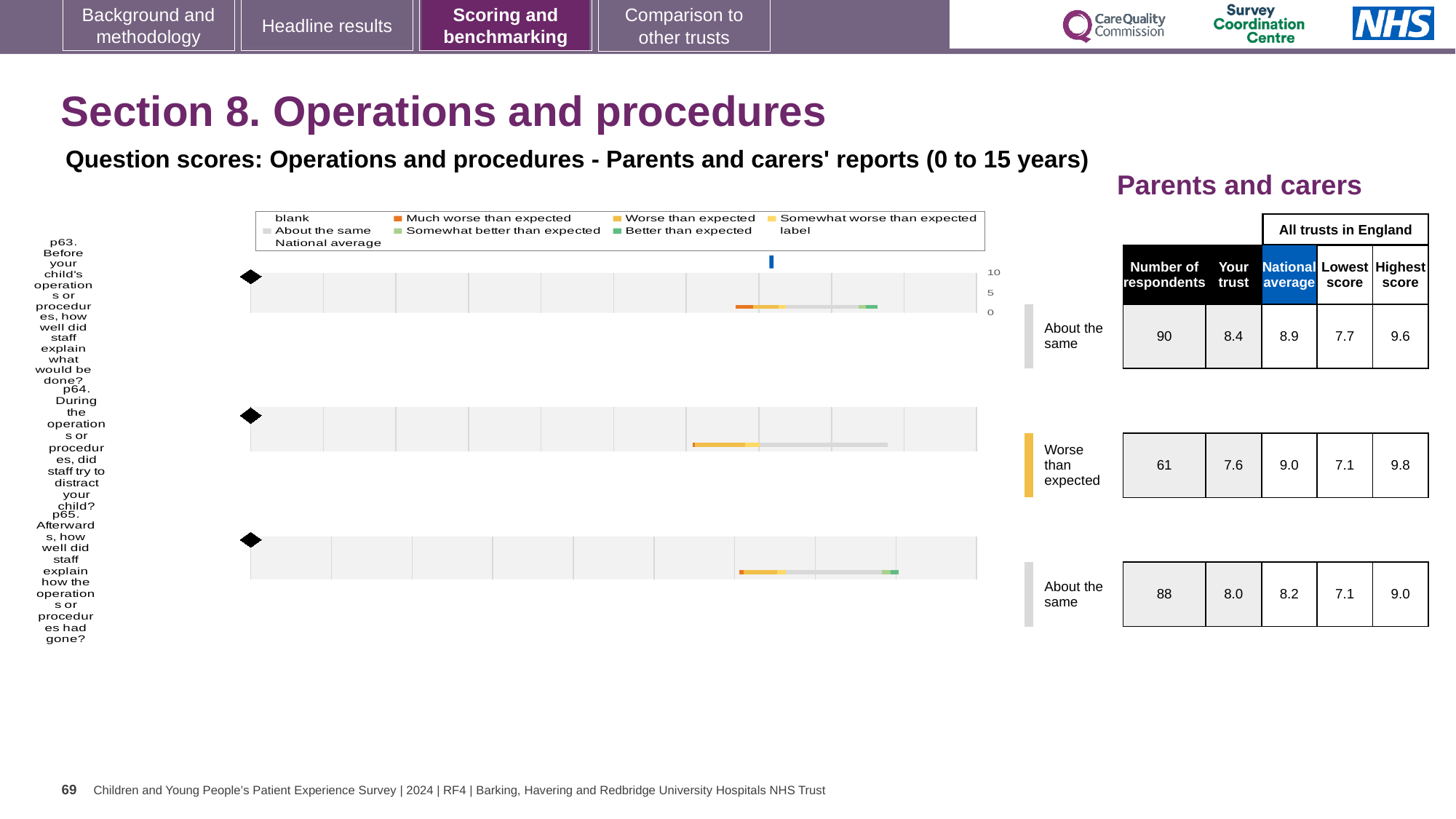
For p64, is the 'Your trust' score higher or lower than the national average? lower For p64, what is the highest score among all trusts in England? 9.8 For p63 (how well staff explained what would be done), what is the 'Your trust' score shown in the table? 8.4 Which of the three questions has the highest 'Your trust' score? p63 For p64, what is the difference between the national average (9.0) and the 'Your trust' score (7.6)? 1.4 Which of the three questions has the lowest number of respondents? p64 How many question charts (p63, p64, p65) are shown on the slide? 3 In the chart legend, what colour represents 'Much worse than expected'? orange In the chart legend, what colour represents 'Better than expected'? green For p65 (how well staff explained how the operation had gone), how many respondents are shown? 88 For p64 (did staff try to distract your child), what is the national average score shown in the table? 9.0 What kind of chart is used to show the question scores for p63, p64 and p65? bar chart